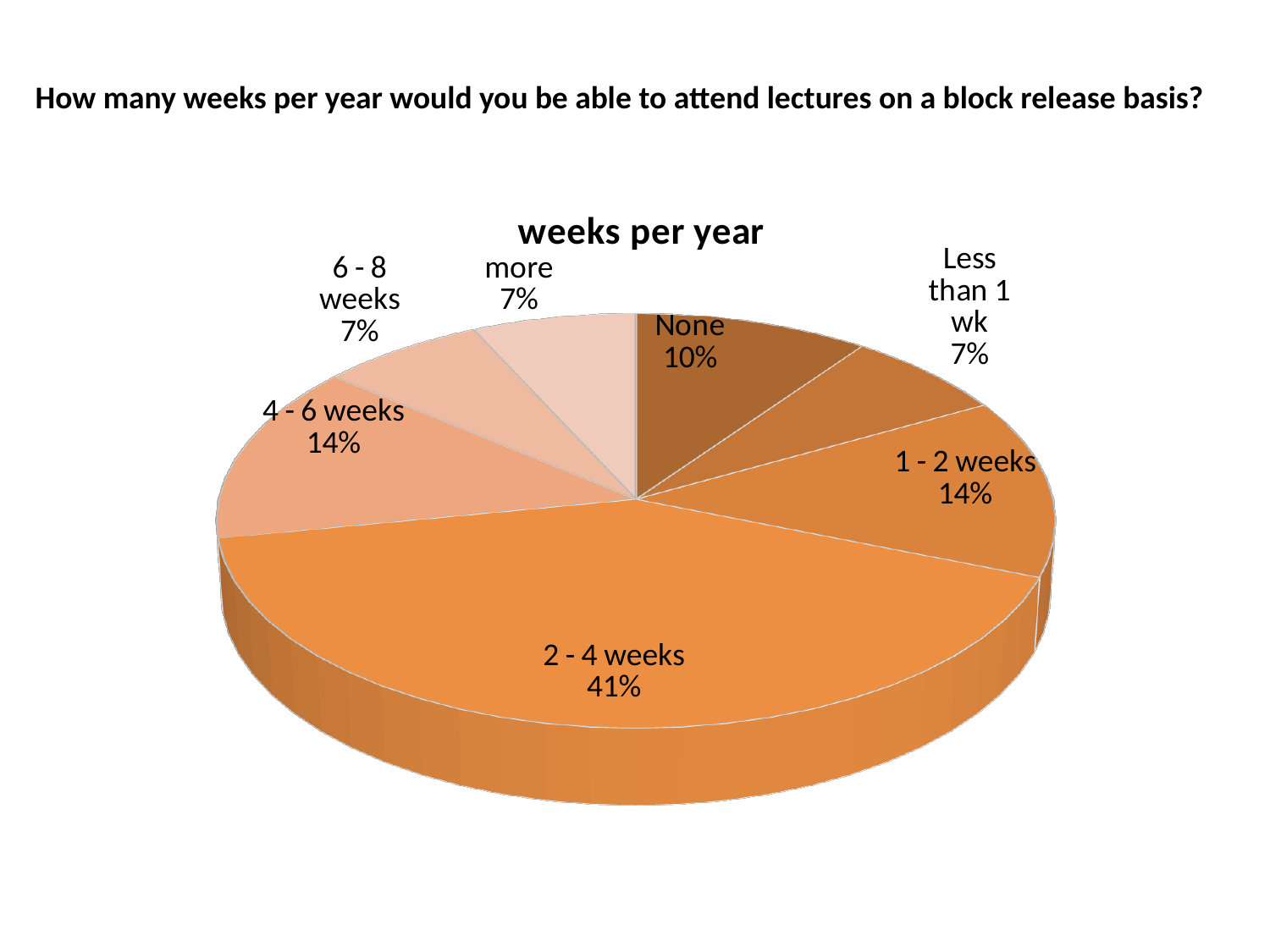
How many categories are shown with a value of 7%? 3 What percentage is shown for "Less than 1 wk"? 7% What percentage is shown for "None"? 10% What is the difference in percentage points between "2 - 4 weeks" and "None"? 31 Which category has the largest slice of the pie? 2 - 4 weeks What is the title of the chart? weeks per year What kind of chart is shown on the slide? pie chart What percentage is shown for "1 - 2 weeks"? 14% Which is larger, the slice for "None" or the slice for "more"? None What share of the pie is labelled "2 - 4 weeks"? 41% How many slices does the pie chart have? 7 What percentage is shown for "4 - 6 weeks"? 14%